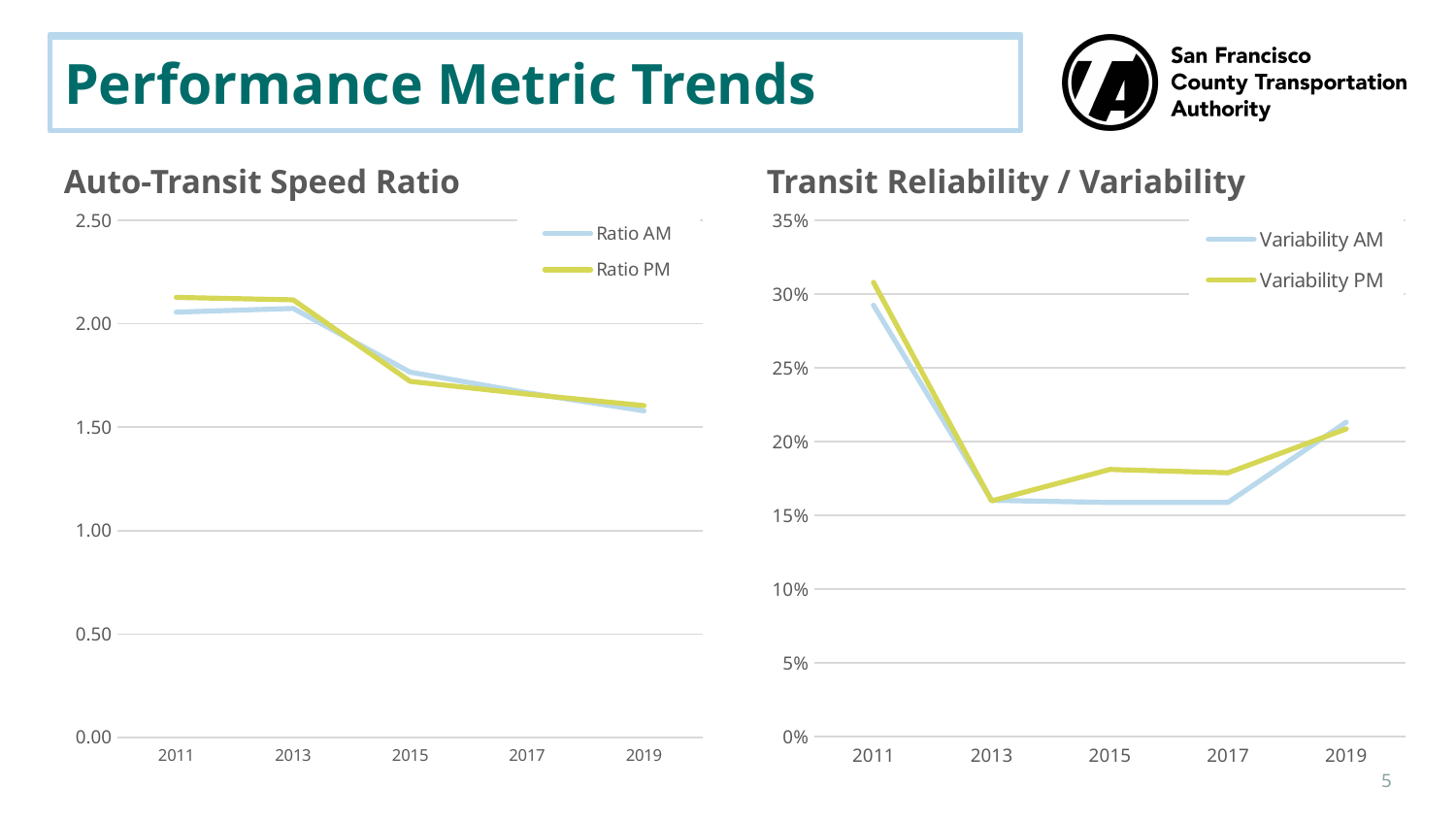
In the Transit Reliability / Variability chart, which year has the lowest Variability PM value? 2013 In the Transit Reliability / Variability chart, which year has the highest Variability PM value? 2011 In the Transit Reliability / Variability chart, which is larger in 2015, Variability AM or Variability PM? Variability PM In the Auto-Transit Speed Ratio chart, is the Ratio AM value for 2019 greater or less than 2.00? less What kind of chart is the Auto-Transit Speed Ratio chart? line chart What are the two series named in the legend of the Auto-Transit Speed Ratio chart? Ratio AM and Ratio PM In the Transit Reliability / Variability chart, is the Variability AM value for 2013 greater or less than 20%? less In the Auto-Transit Speed Ratio chart, which year has the lowest Ratio AM value? 2019 How many series does the legend of the Transit Reliability / Variability chart list? 2 In the Auto-Transit Speed Ratio chart, do the Ratio PM values generally rise or fall from 2011 to 2019? fall In the Auto-Transit Speed Ratio chart, is the Ratio PM value for 2011 greater or less than 2.00? greater How many years are plotted on the x axis of the Auto-Transit Speed Ratio chart? 5